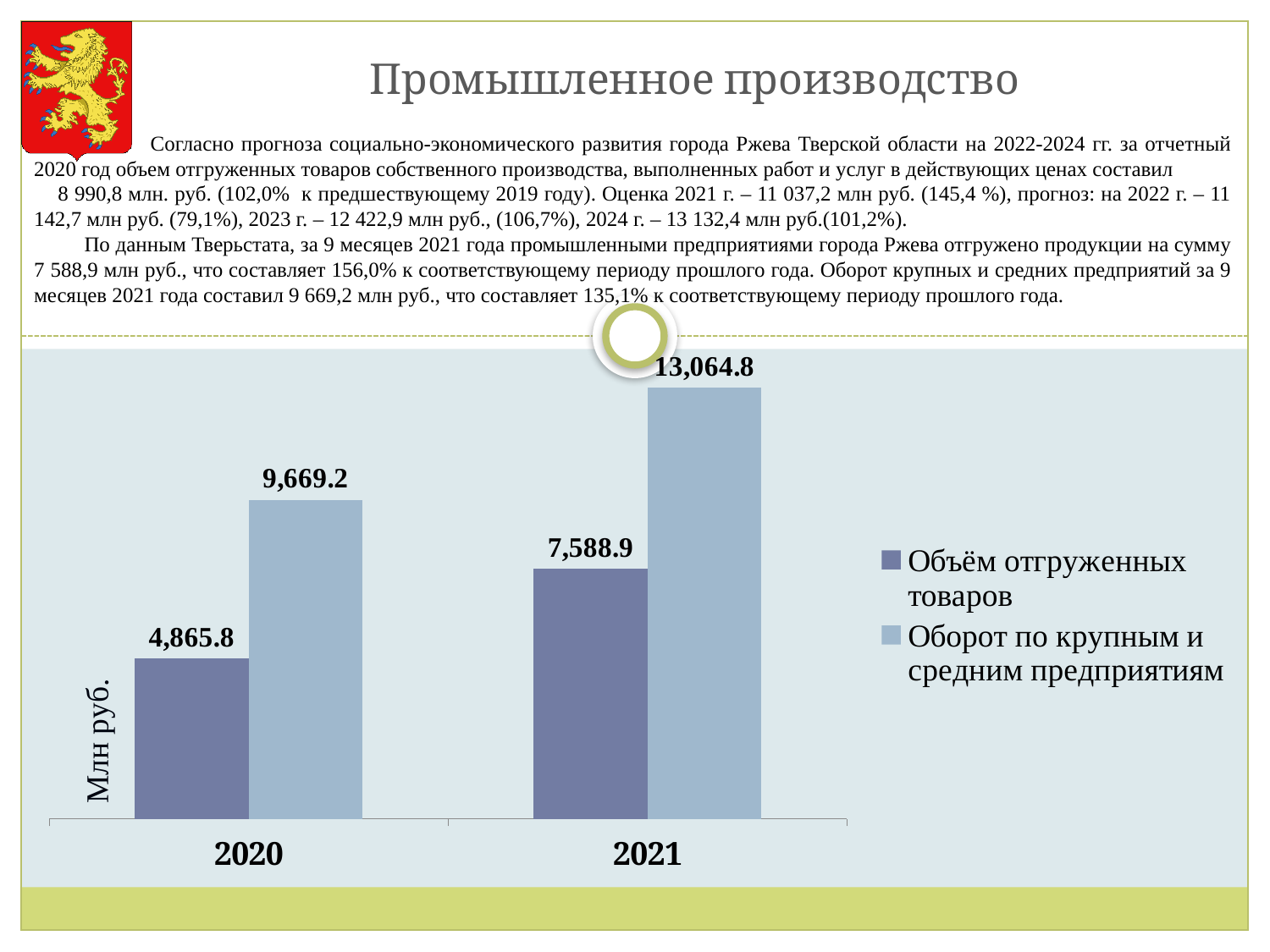
What is the value of "Оборот по крупным и средним предприятиям" for 2021? 13,064.8 What is the value of "Объём отгруженных товаров" for 2021? 7,588.9 By how much did "Объём отгруженных товаров" increase from 2020 to 2021? 2,723.1 What type of chart is shown on the slide? Bar chart What is the difference between "Оборот по крупным и средним предприятиям" in 2021 and in 2020? 3,395.6 Which is larger in 2020: "Объём отгруженных товаров" or "Оборот по крупным и средним предприятиям"? Оборот по крупным и средним предприятиям What unit is shown on the vertical axis label of the chart? Млн руб. Which bar on the chart has the highest value? Оборот по крупным и средним предприятиям, 2021 Which bar on the chart has the lowest value? Объём отгруженных товаров, 2020 What is the value of "Оборот по крупным и средним предприятиям" for 2020? 9,669.2 What is the value of "Объём отгруженных товаров" for 2020? 4,865.8 How many series does the legend list? 2